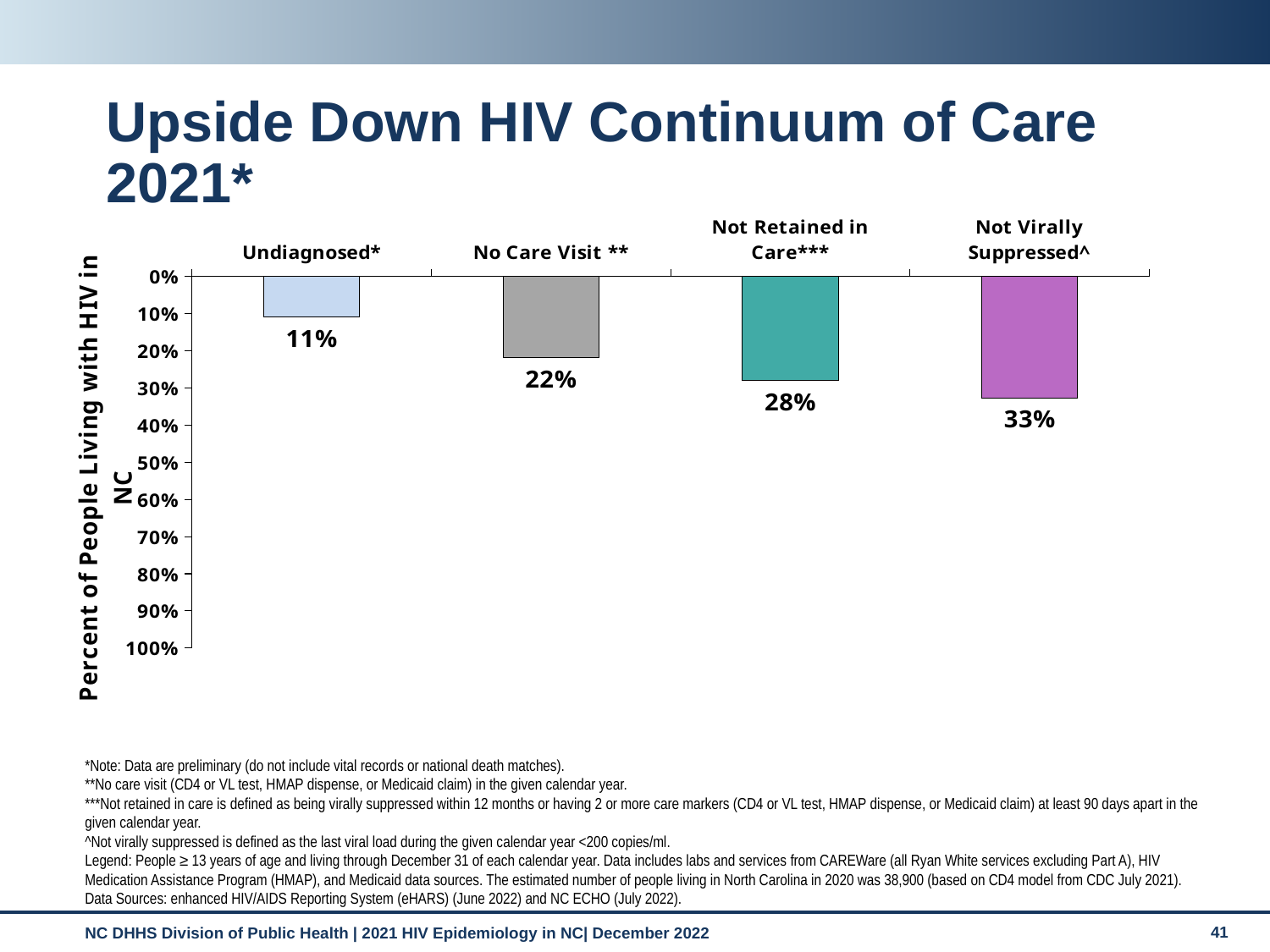
What is the difference between the values for Not Virally Suppressed^ and Undiagnosed*? 22% What is the value for No Care Visit **? 22% Which is larger, the value for No Care Visit ** or the value for Not Retained in Care***? Not Retained in Care*** What is the value for Not Retained in Care***? 28% Which category has the lowest value? Undiagnosed* What kind of chart is shown on the slide? Bar chart Which category has the highest value? Not Virally Suppressed^ What is the value for Not Virally Suppressed^? 33% How many categories are shown in the chart? 4 What is the value for Undiagnosed*? 11% Do the values rise or fall moving from left to right across the categories? Rise What is the label of the vertical axis? Percent of People Living with HIV in NC